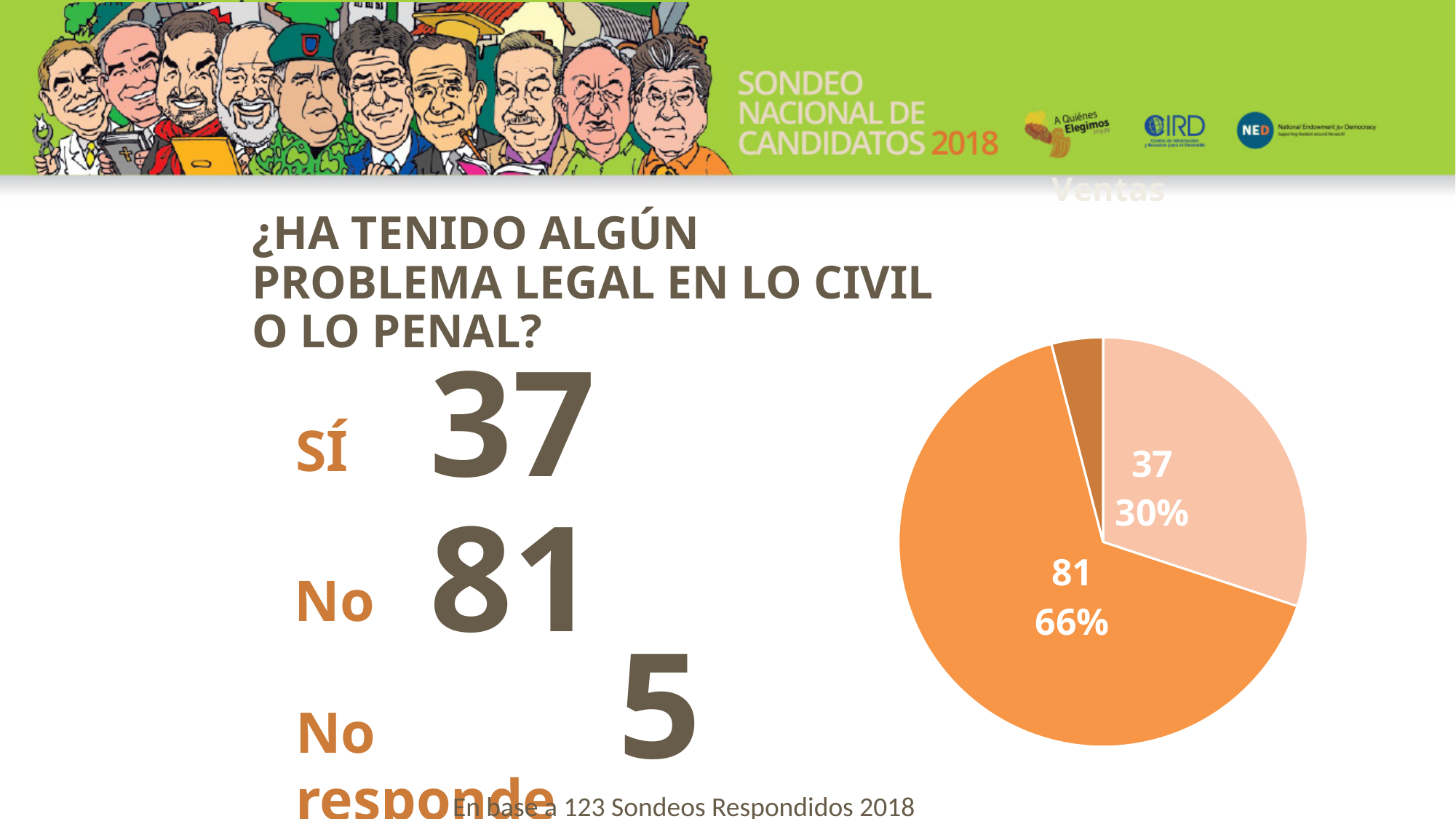
What value is printed on the largest slice of the pie chart? 81 What is the difference between the two values printed on the pie chart, 81 and 37? 44 Which response has the smallest slice in the pie chart: Sí, No, or No responde? No responde According to the slide, how many respondents answered Sí? 37 What value is printed on the light-coloured slice of the pie chart? 37 Which is larger in the pie chart, the slice labelled 81 or the slice labelled 37? 81 What percentage is shown on the light-coloured slice of the pie chart? 30% What kind of chart is shown on the slide? pie chart How many slices does the pie chart have? 3 Which response has the largest slice in the pie chart: Sí, No, or No responde? No What percentage is shown on the largest slice of the pie chart? 66% According to the slide, how many respondents answered No responde? 5